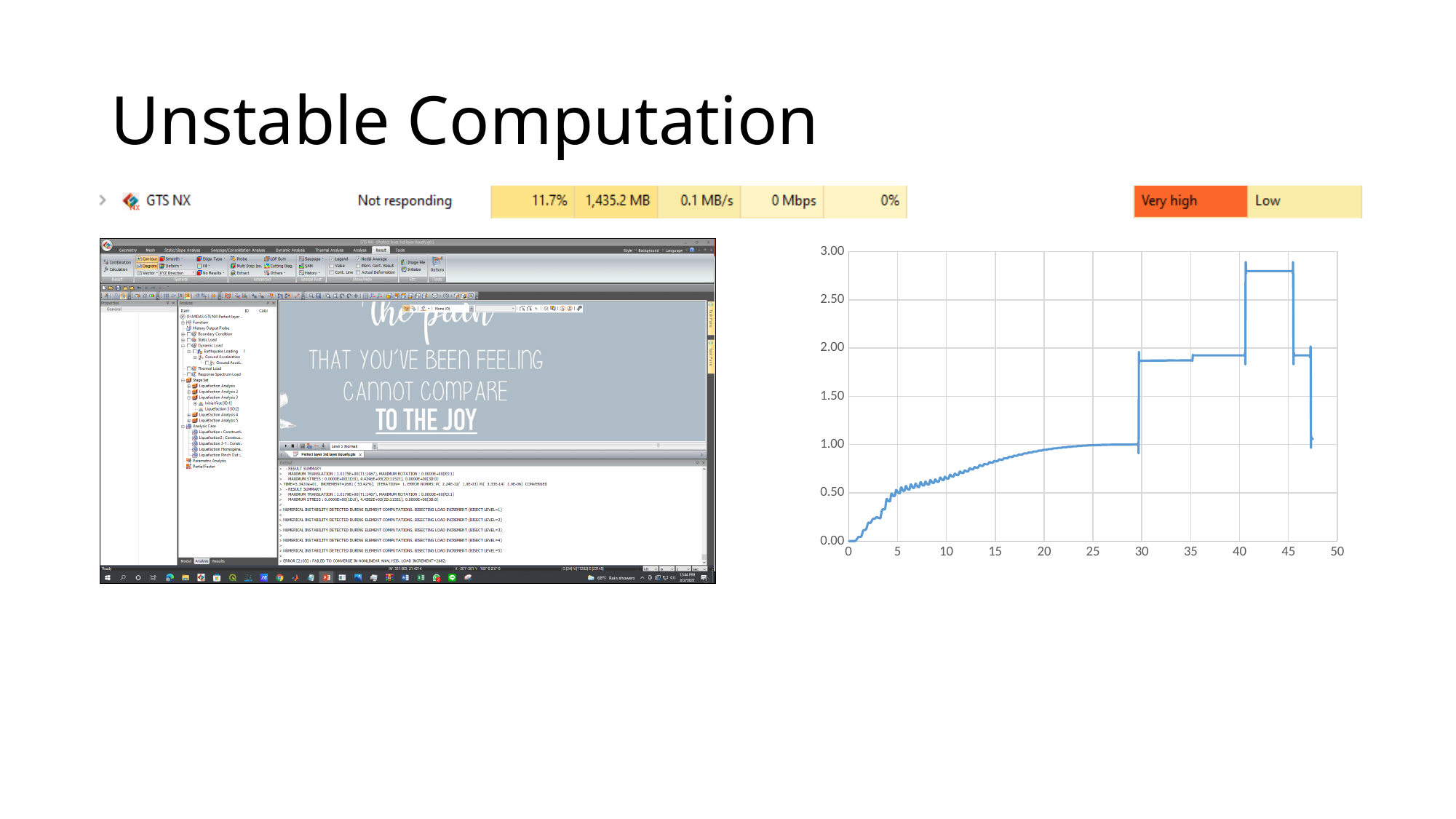
What kind of chart is shown on the right side of the slide? line chart On the line chart, is the value at x = 43 greater or less than 2.50? greater On the line chart, is the value at x = 25 greater or less than 1.50? less On the line chart, in which x-axis interval does the line reach its highest values? between 40 and 45 On the line chart, is the value at x = 35 greater or less than 1.50? greater What is the highest tick label on the y axis of the line chart? 3.00 What is the highest tick label on the x axis of the line chart? 50 On the line chart, which is larger: the value at x = 43 or the value at x = 20? the value at x = 43 On the line chart, does the line rise or fall between x = 0 and x = 30? rise